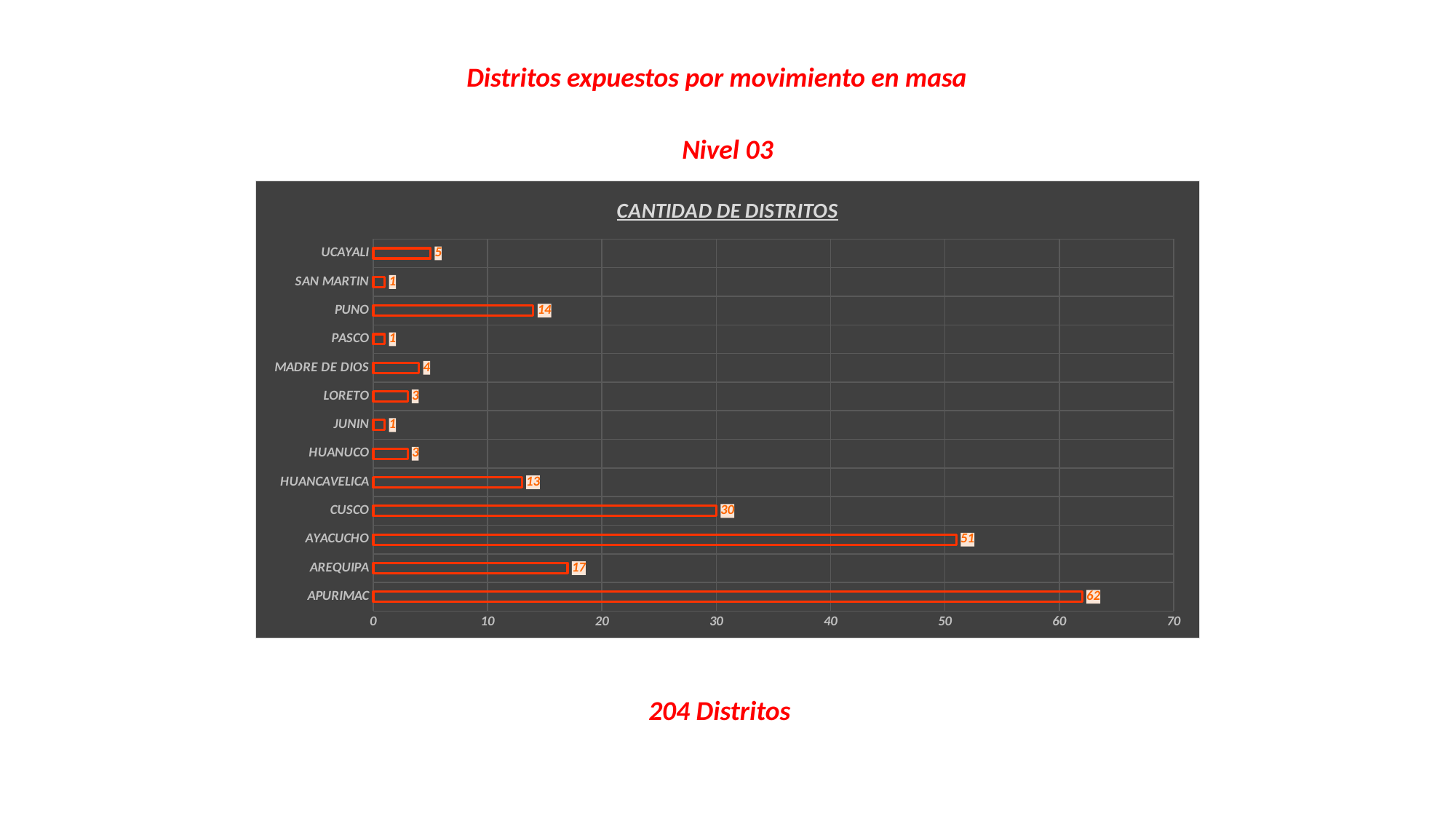
What is the value for HUANCAVELICA? 13 Is the value for AYACUCHO greater or less than 50? greater Which is larger, the value for PUNO or the value for HUANCAVELICA? PUNO What is the value for CUSCO? 30 What is the value for MADRE DE DIOS? 4 How many categories are shown on the chart? 13 What is the title of the chart? CANTIDAD DE DISTRITOS What is the difference between the values for AYACUCHO and AREQUIPA? 34 What is the value for APURIMAC? 62 What kind of chart is shown? bar chart What is the difference between the values for APURIMAC and CUSCO? 32 Which category has the highest value? APURIMAC